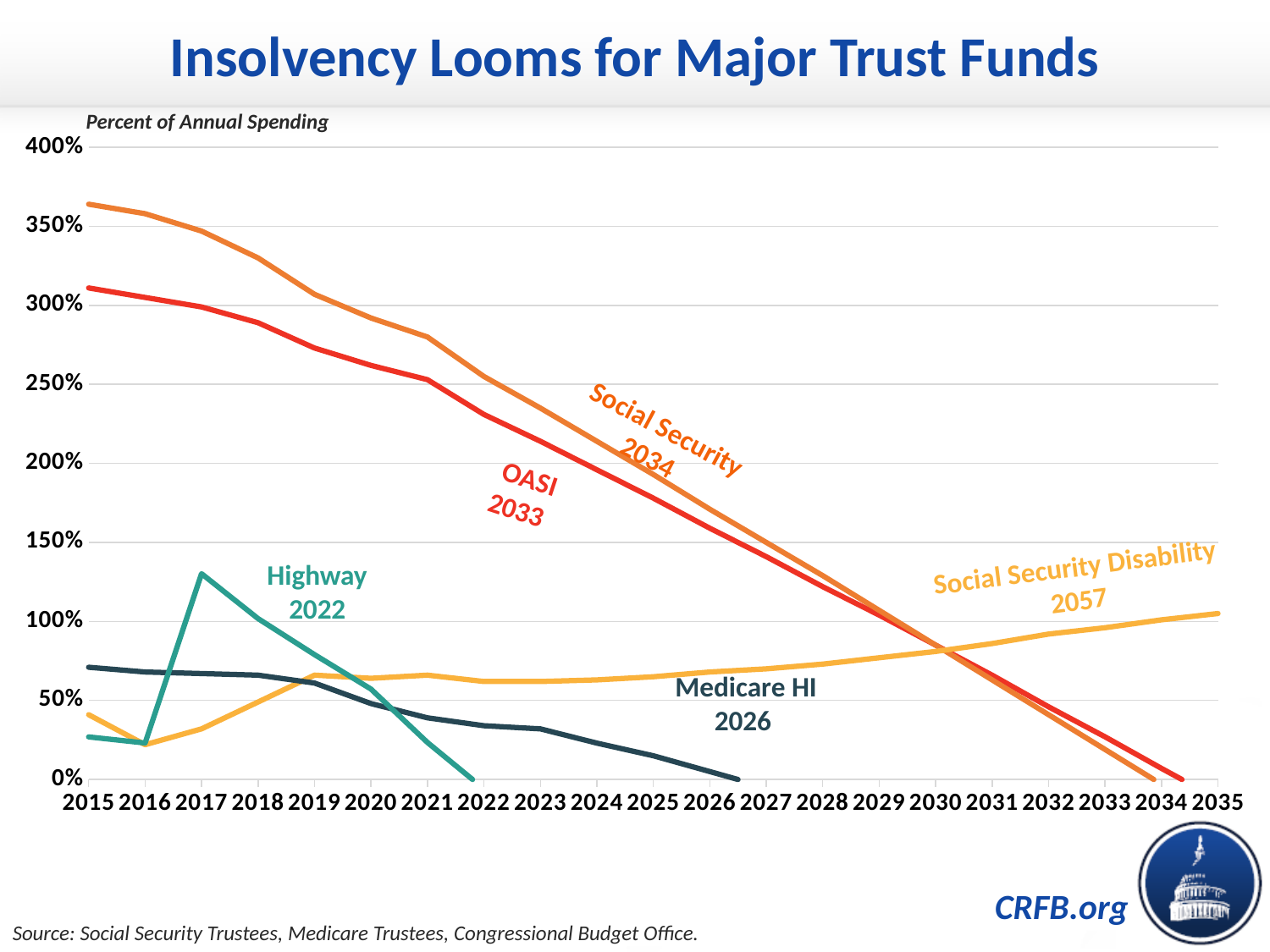
Does the Social Security Disability line rise or fall overall from 2015 to 2035? rise What kind of chart is shown on the slide? line chart Is the value for Social Security in 2015 greater or less than 350%? greater What insolvency year is labeled for the Highway trust fund? 2022 Which trust fund has the highest value in 2015? Social Security Which trust fund has the lowest value in 2015? Highway What is the label on the vertical axis of the chart? Percent of Annual Spending Does the Medicare HI line rise or fall from 2015 to 2026? fall How many trust funds are plotted as lines on the chart? 5 Is the value for Highway in 2017 greater or less than 100%? greater Is the value for Medicare HI in 2015 greater or less than 50%? greater In 2033, which is higher: Social Security Disability or OASI? Social Security Disability